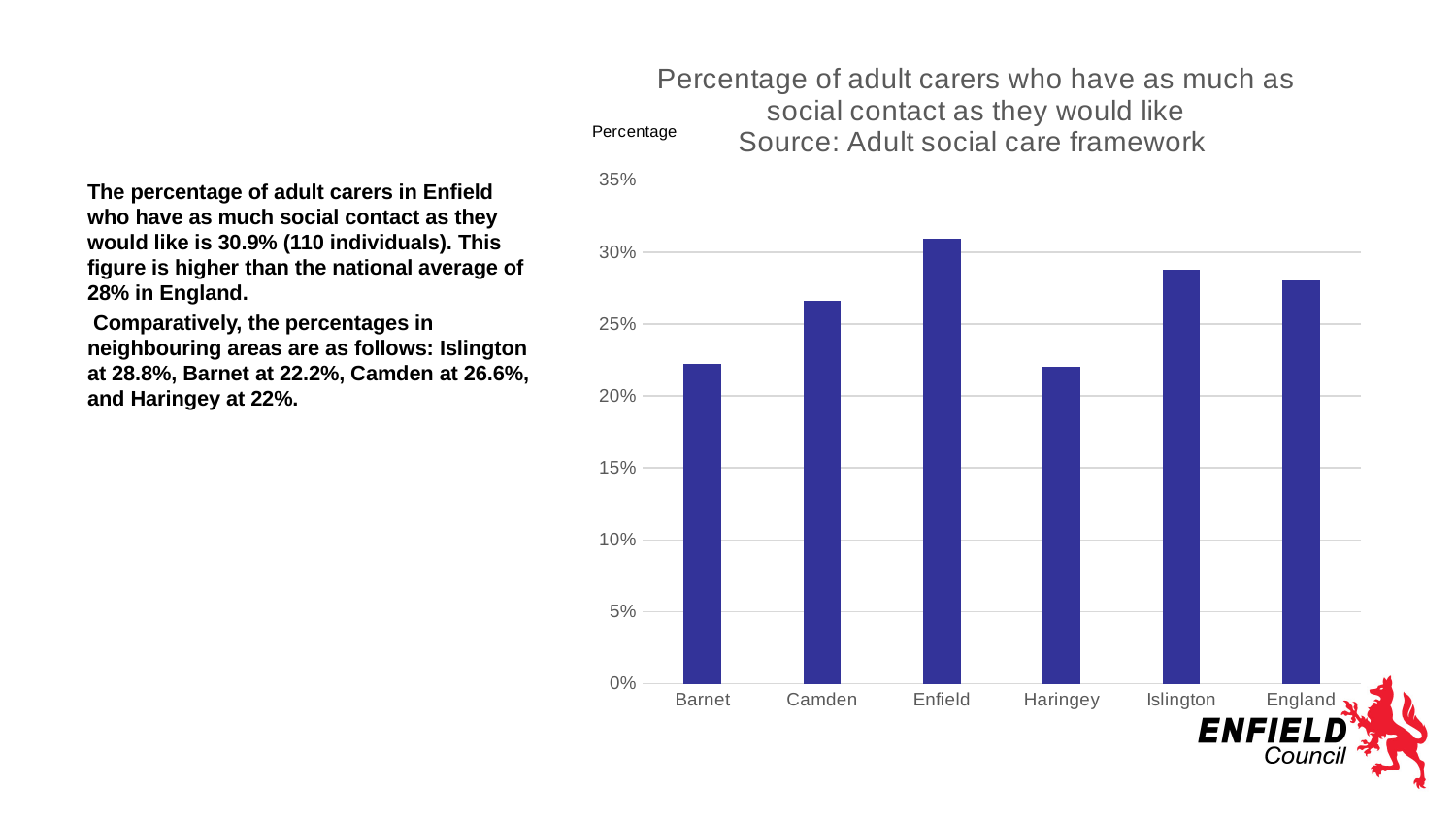
Is the value for Barnet greater or less than 25%? less Which is larger, the value for Islington or the value for Barnet? Islington According to the chart title, what is the source of the data? Adult social care framework Is the value for England greater or less than 30%? less What is the label on the vertical axis of the chart? Percentage Is the value for Camden greater or less than 25%? greater Which area has the highest percentage of adult carers who have as much social contact as they would like? Enfield Which is larger, the value for Enfield or the value for Camden? Enfield How many areas are shown on the x axis of the chart? 6 What kind of chart is shown on the slide? bar chart